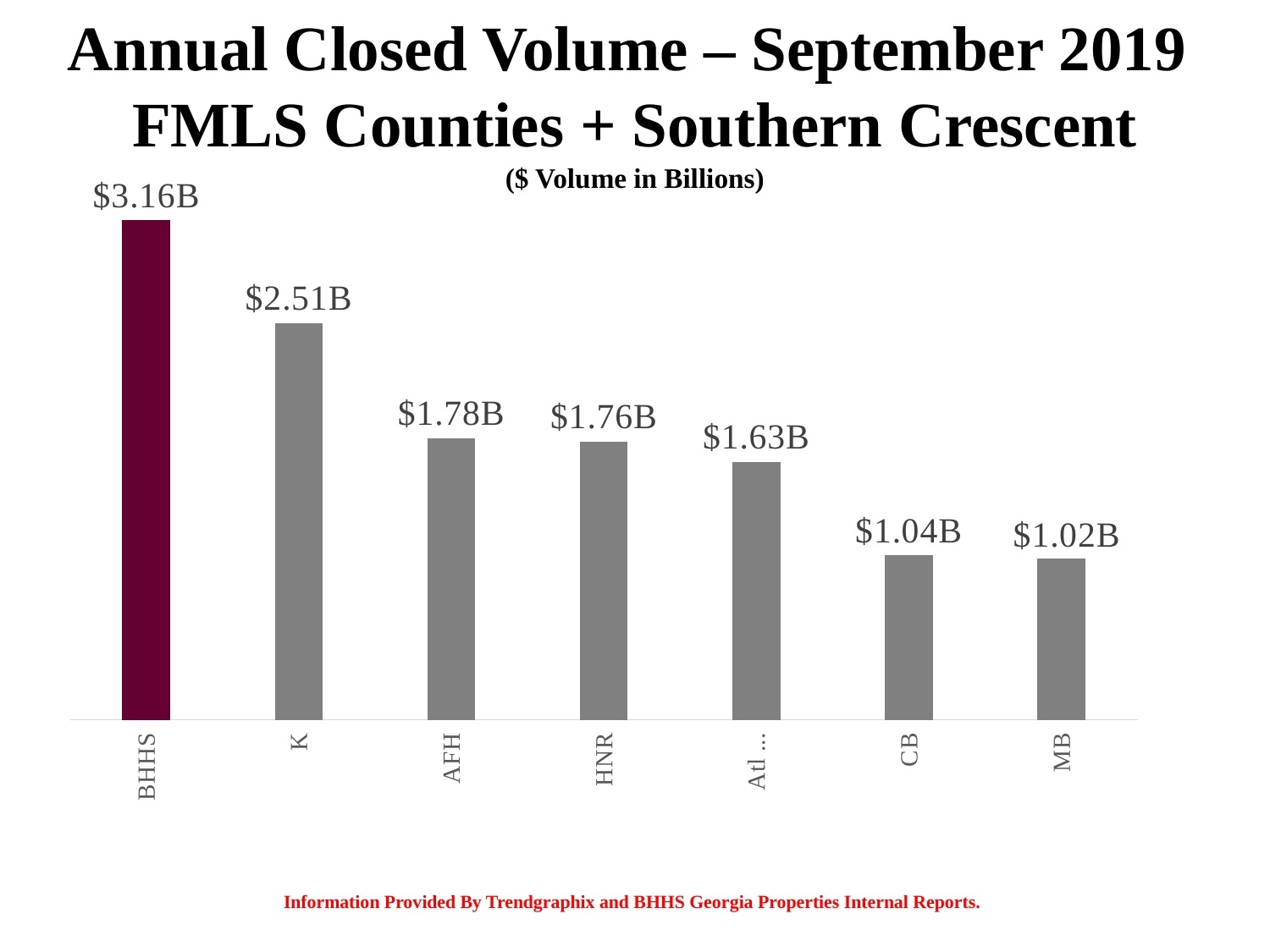
Which company has the lowest annual closed volume? MB What type of chart is shown on the slide? Bar chart How many bars are shown in the chart? 7 What is the annual closed volume for BHHS? $3.16B What is the difference in annual closed volume between BHHS and K? $0.65B What is the annual closed volume for HNR? $1.76B What is the annual closed volume for AFH? $1.78B Which company has the highest annual closed volume? BHHS What is the annual closed volume for CB? $1.04B Which has a larger annual closed volume, AFH or HNR? AFH What is the annual closed volume for K? $2.51B What is the annual closed volume for MB? $1.02B